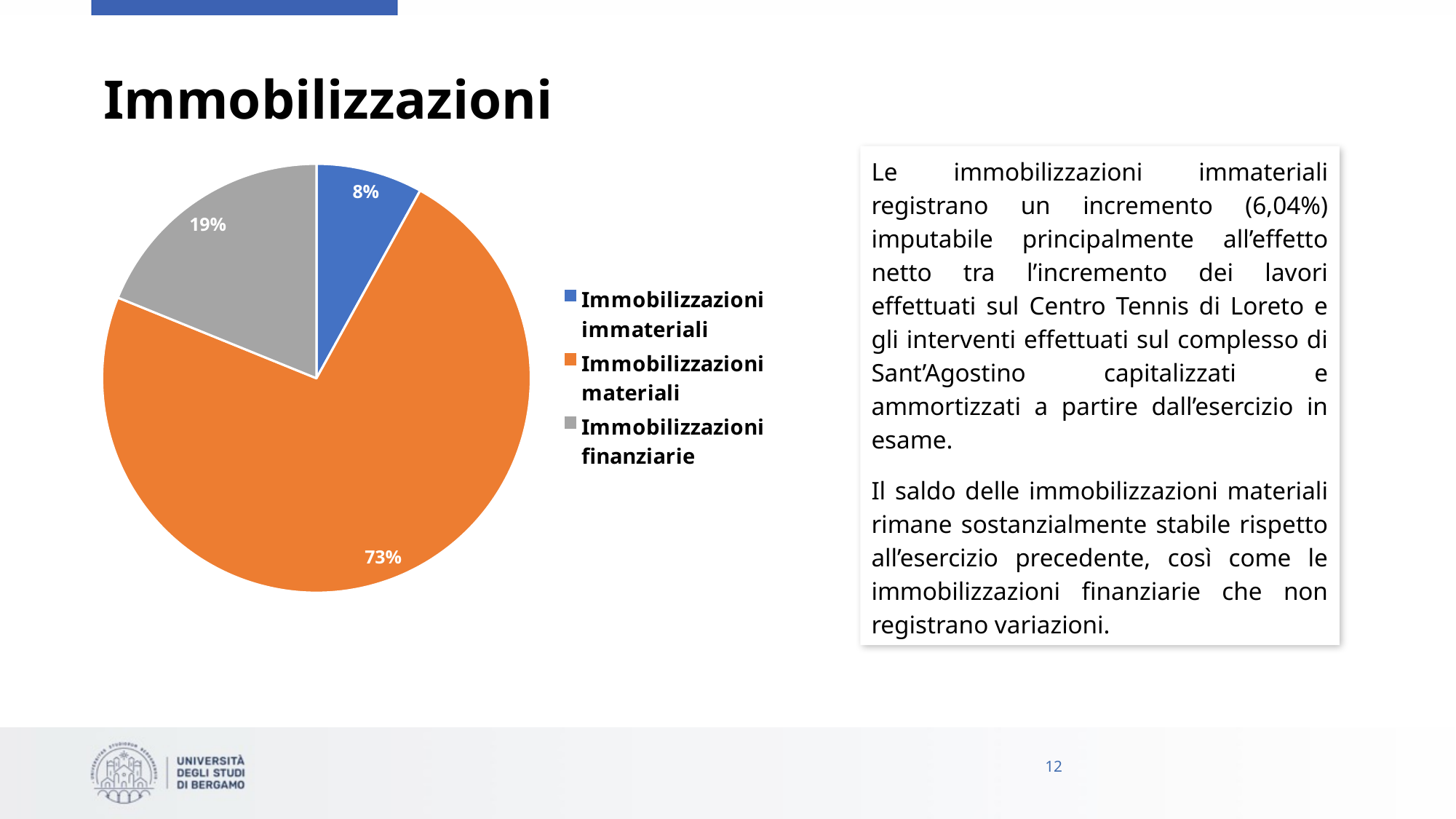
What share of the pie does Immobilizzazioni materiali represent? 73% What colour is the slice for Immobilizzazioni materiali? Orange What is the difference in percentage points between Immobilizzazioni materiali and Immobilizzazioni finanziarie? 54 Which category has the largest slice of the pie? Immobilizzazioni materiali How many slices does the pie chart have? 3 Which is larger, the slice for Immobilizzazioni finanziarie or the slice for Immobilizzazioni immateriali? Immobilizzazioni finanziarie What share of the pie does Immobilizzazioni immateriali represent? 8% What kind of chart is shown on the slide? Pie chart What share of the pie does Immobilizzazioni finanziarie represent? 19% How many entries does the legend list? 3 What is the difference in percentage points between Immobilizzazioni finanziarie and Immobilizzazioni immateriali? 11 Which category has the smallest slice of the pie? Immobilizzazioni immateriali